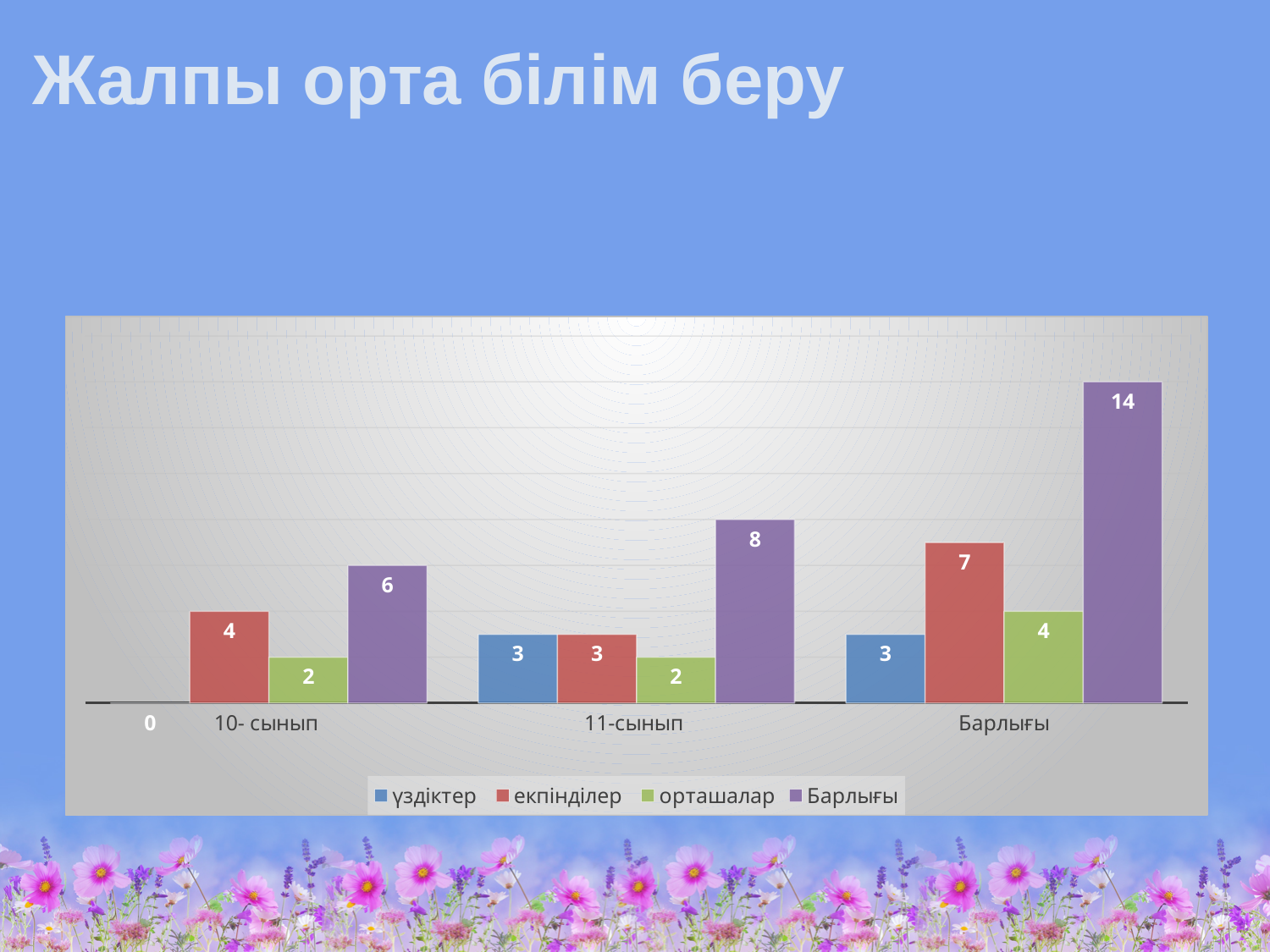
What is the title of the slide? Жалпы орта білім беру What kind of chart is shown on the slide? bar chart Which is larger: Барлығы for 11-сынып or Барлығы for 10- сынып? 11-сынып What is the difference between екпінділер for Барлығы and екпінділер for 10- сынып? 3 What is the value of үздіктер for 10- сынып? 0 What is the value of екпінділер for 10- сынып? 4 How many series does the legend list? 4 Which category has the highest value for the Барлығы series? Барлығы What is the value of Барлығы for 11-сынып? 8 Which category has the lowest value for the екпінділер series? 11-сынып How many categories are shown on the x axis? 3 What is the value of орташалар for Барлығы? 4